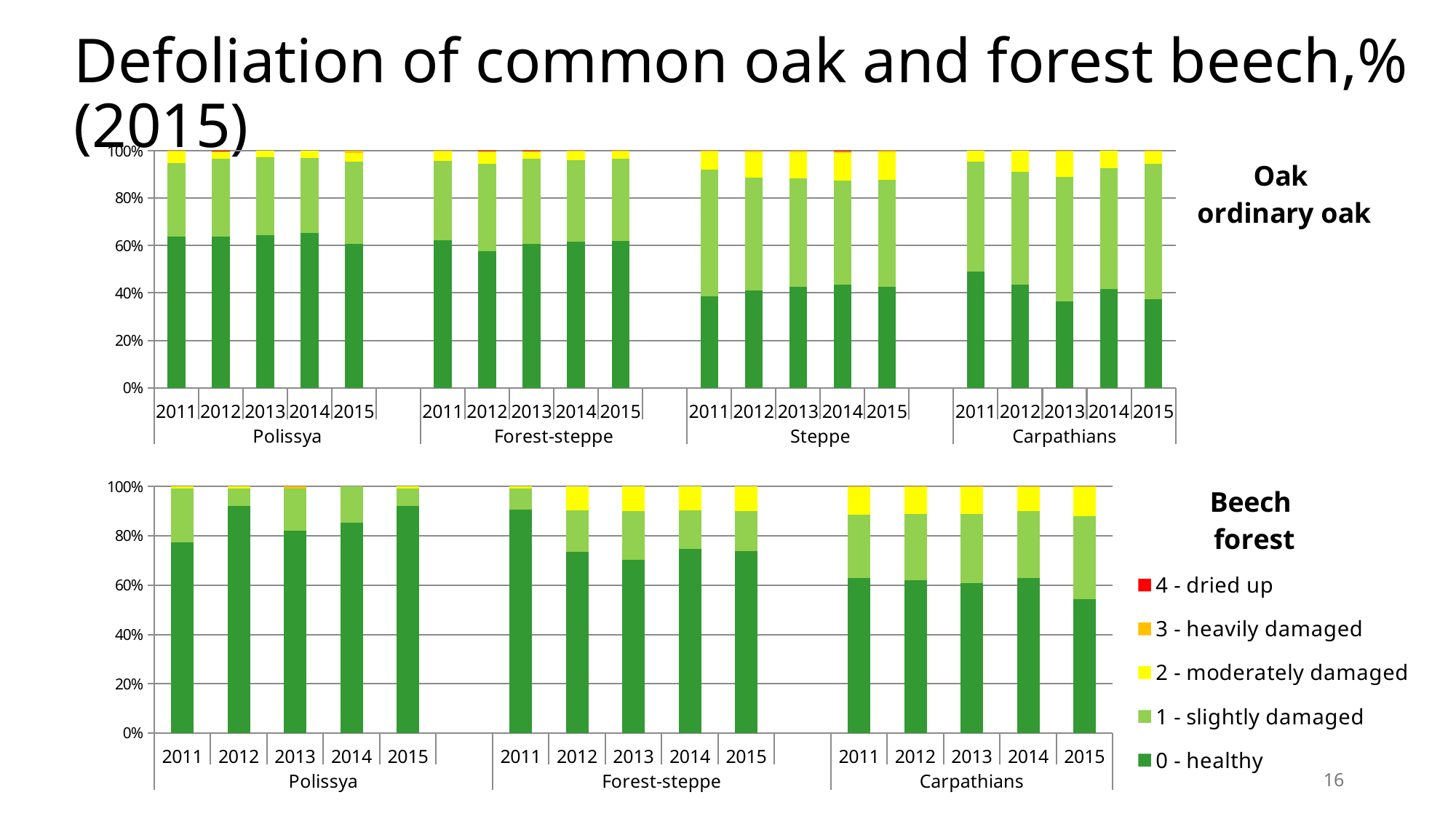
Which legend entry is shown in yellow? 2 - moderately damaged How many regions are shown on the x axis of the top chart (Oak ordinary oak)? 4 In the top chart (Oak ordinary oak), which has the larger '0 - healthy' share: Polissya in 2014 or Steppe in 2011? Polissya in 2014 How many regions are shown on the x axis of the bottom chart (Beech forest)? 3 What kind of chart is the top chart (Oak ordinary oak)? Stacked bar chart In the bottom chart (Beech forest), does the '0 - healthy' share for Carpathians rise or fall from 2014 to 2015? fall How many series does the legend list? 5 In the bottom chart (Beech forest), is the '0 - healthy' share for Polissya in 2012 greater or less than 80%? greater In the top chart (Oak ordinary oak), which region has the lowest '0 - healthy' share in 2011? Steppe In the bottom chart (Beech forest), which region has the highest '0 - healthy' share in 2015? Polissya In the bottom chart (Beech forest), is the '0 - healthy' share for Carpathians in 2015 greater or less than 60%? less In the top chart (Oak ordinary oak), is the '0 - healthy' share for Carpathians in 2013 greater or less than 40%? less